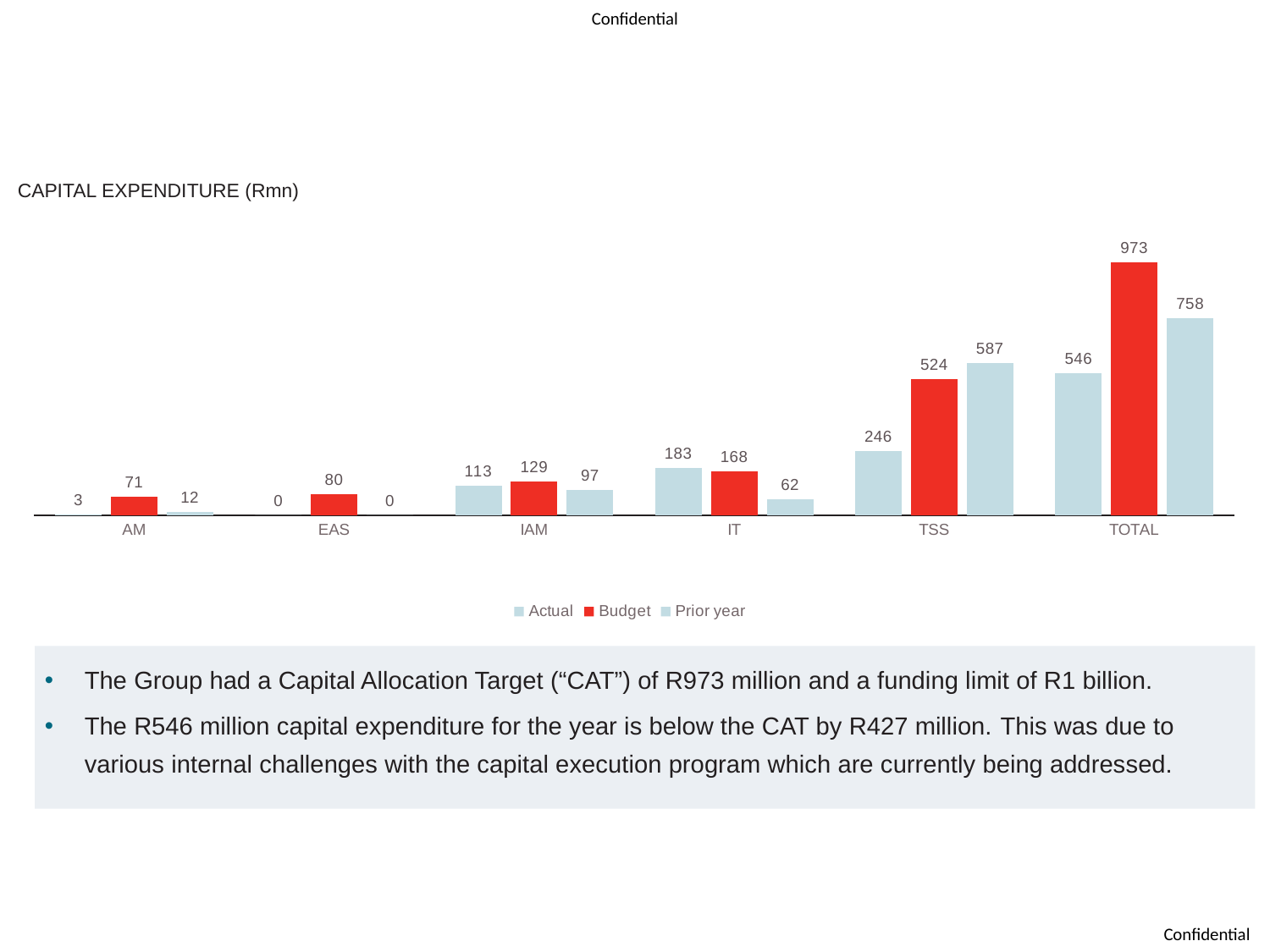
How many categories are shown on the x axis? 6 How many series does the legend list? 3 What is the difference between the Budget and Actual values for TOTAL? 427 Which is larger for IT, the Actual value or the Budget value? Actual Which category has the lowest Budget value? AM What is the Actual capital expenditure for TSS? 246 What is the Prior year value for IT? 62 What is the Budget value for IAM? 129 Which category has the highest Actual value, excluding TOTAL? TSS What is the Budget value for TOTAL? 973 What kind of chart is shown on the slide? Bar chart What is the title of the chart? CAPITAL EXPENDITURE (Rmn)